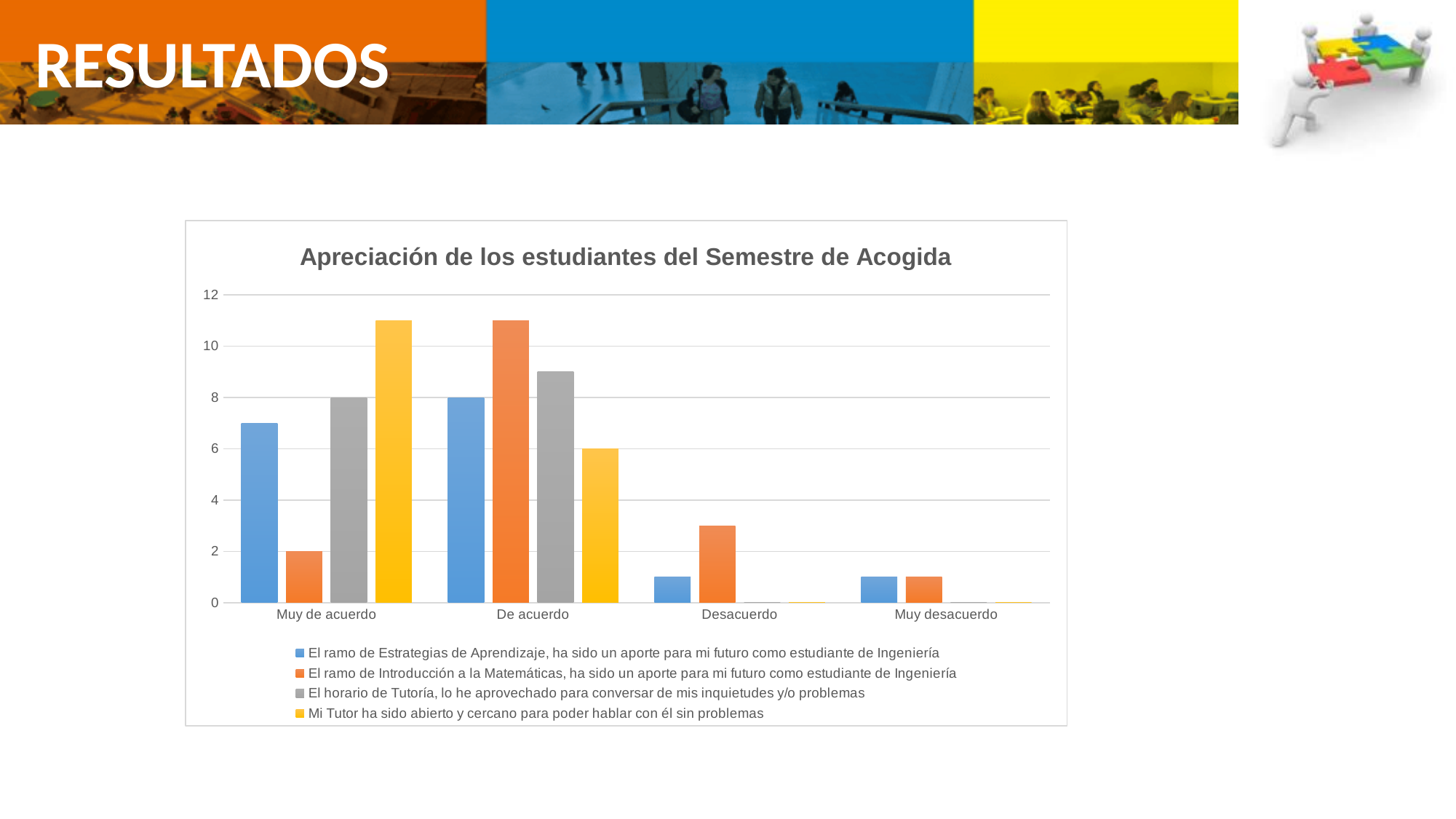
What is the title of the chart? Apreciación de los estudiantes del Semestre de Acogida How many series does the legend list? 4 Is the value for 'El ramo de Introducción a la Matemáticas...' in the 'De acuerdo' category greater or less than 10? greater What is the value for 'Mi Tutor ha sido abierto y cercano para poder hablar con él sin problemas' in the 'De acuerdo' category? 6 What kind of chart is shown on the slide? bar chart In the 'De acuerdo' category, which is larger: the value for 'El ramo de Estrategias de Aprendizaje...' or the value for 'Mi Tutor ha sido abierto y cercano...'? El ramo de Estrategias de Aprendizaje, ha sido un aporte para mi futuro como estudiante de Ingeniería Which series has the lowest value in the 'Muy de acuerdo' category? El ramo de Introducción a la Matemáticas, ha sido un aporte para mi futuro como estudiante de Ingeniería What is the value for 'El horario de Tutoría, lo he aprovechado para conversar de mis inquietudes y/o problemas' in the 'Muy de acuerdo' category? 8 What is the value for 'El ramo de Introducción a la Matemáticas, ha sido un aporte para mi futuro como estudiante de Ingeniería' in the 'Muy de acuerdo' category? 2 Which series has the highest value in the 'Muy de acuerdo' category? Mi Tutor ha sido abierto y cercano para poder hablar con él sin problemas How many categories are shown on the x axis of the chart? 4 What is the difference between the 'Muy de acuerdo' values for 'El horario de Tutoría...' and 'El ramo de Introducción a la Matemáticas...'? 6